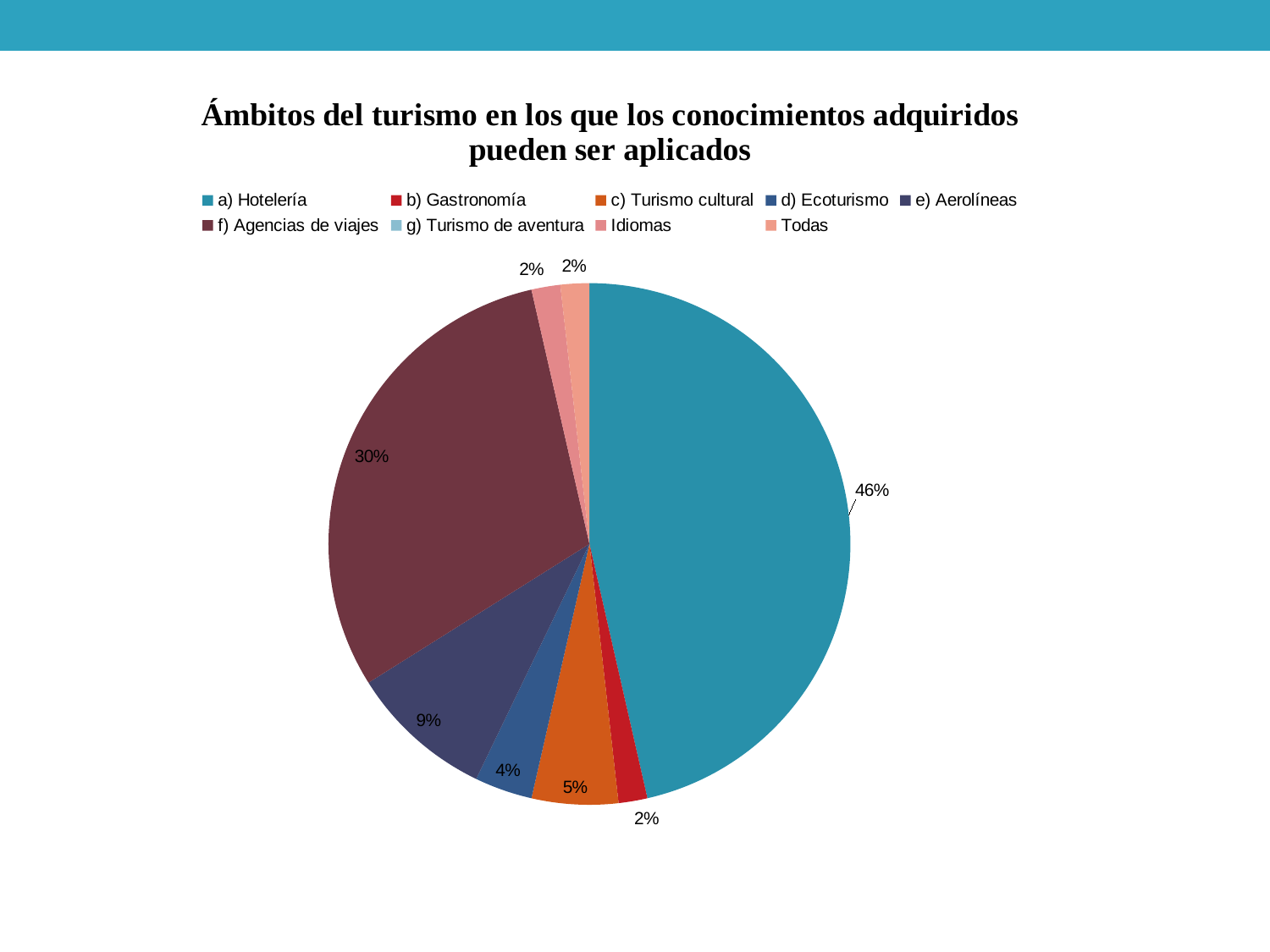
What percentage is shown for c) Turismo cultural? 5% What is the combined share of a) Hotelería and f) Agencias de viajes? 76% What kind of chart is shown on the slide? Pie chart What percentage is shown for f) Agencias de viajes? 30% What is the value for d) Ecoturismo? 4% How many entries does the legend list? 9 Which is larger, e) Aerolíneas or c) Turismo cultural? e) Aerolíneas What is the value for e) Aerolíneas? 9% What is the title of the chart? Ámbitos del turismo en los que los conocimientos adquiridos pueden ser aplicados What is the difference in percentage points between a) Hotelería and f) Agencias de viajes? 16 Which category has the largest share of the pie? a) Hotelería What percentage of the pie does a) Hotelería represent? 46%